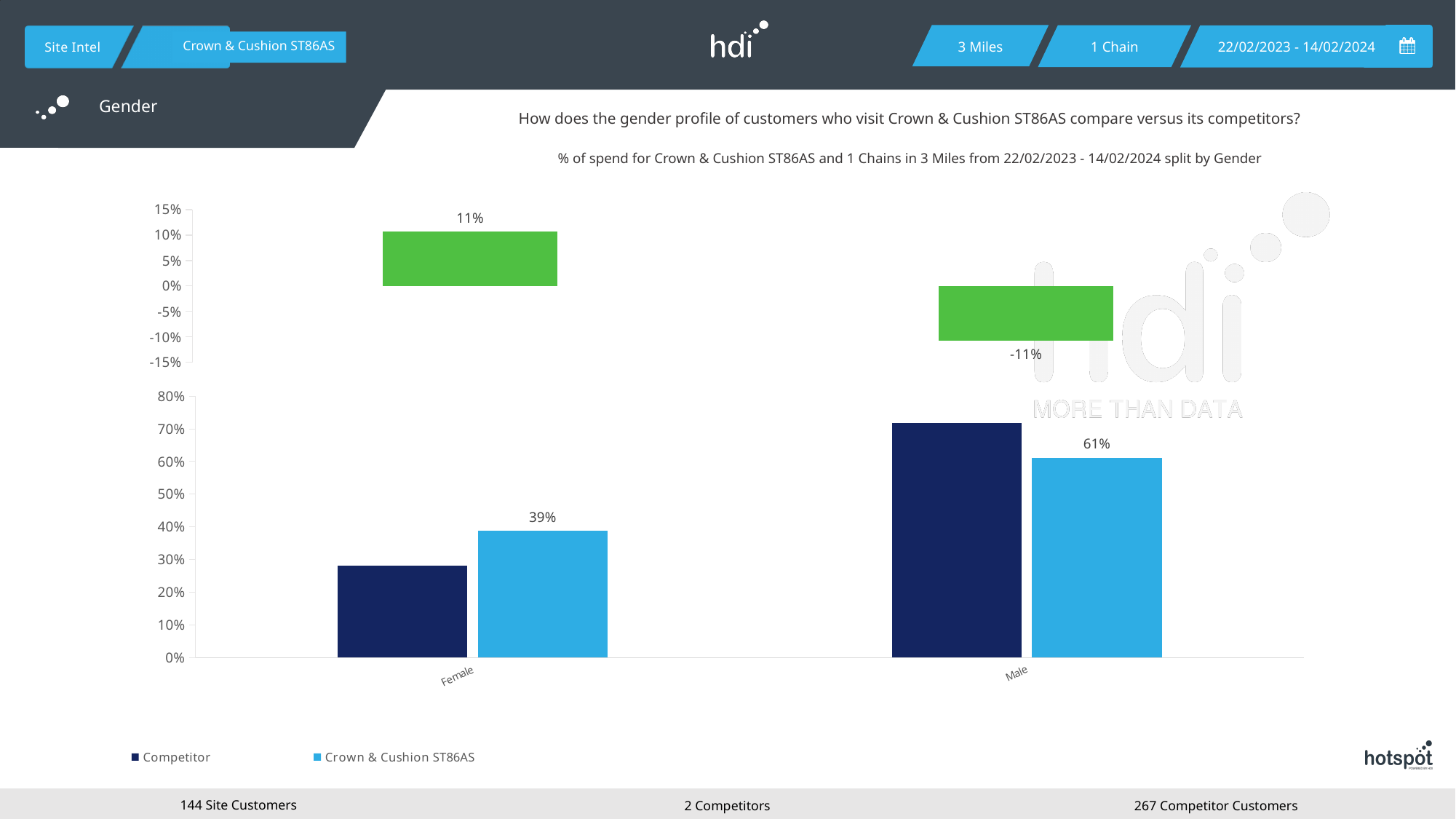
In the top chart with green bars, what is the value shown for Female? 11% In the bottom bar chart, what is the value for Crown & Cushion ST86AS for Female? 39% In the bottom bar chart, which is larger for Male: the Competitor value or the Crown & Cushion ST86AS value? Competitor In the bottom bar chart, what is the value for Crown & Cushion ST86AS for Male? 61% How many series does the legend of the bottom bar chart list? 2 In the bottom bar chart, is the Competitor value for Female greater or less than 30%? less In the bottom bar chart, is the Competitor value for Male greater or less than 70%? greater In the top chart with green bars, what is the value shown for Male? -11% In the bottom bar chart, what is the difference between the Crown & Cushion ST86AS values for Male and Female? 22% What kind of chart is the bottom chart? bar chart How many gender categories are shown on the x axis of the bottom bar chart? 2 In the bottom bar chart, which is larger for Female: the Competitor value or the Crown & Cushion ST86AS value? Crown & Cushion ST86AS